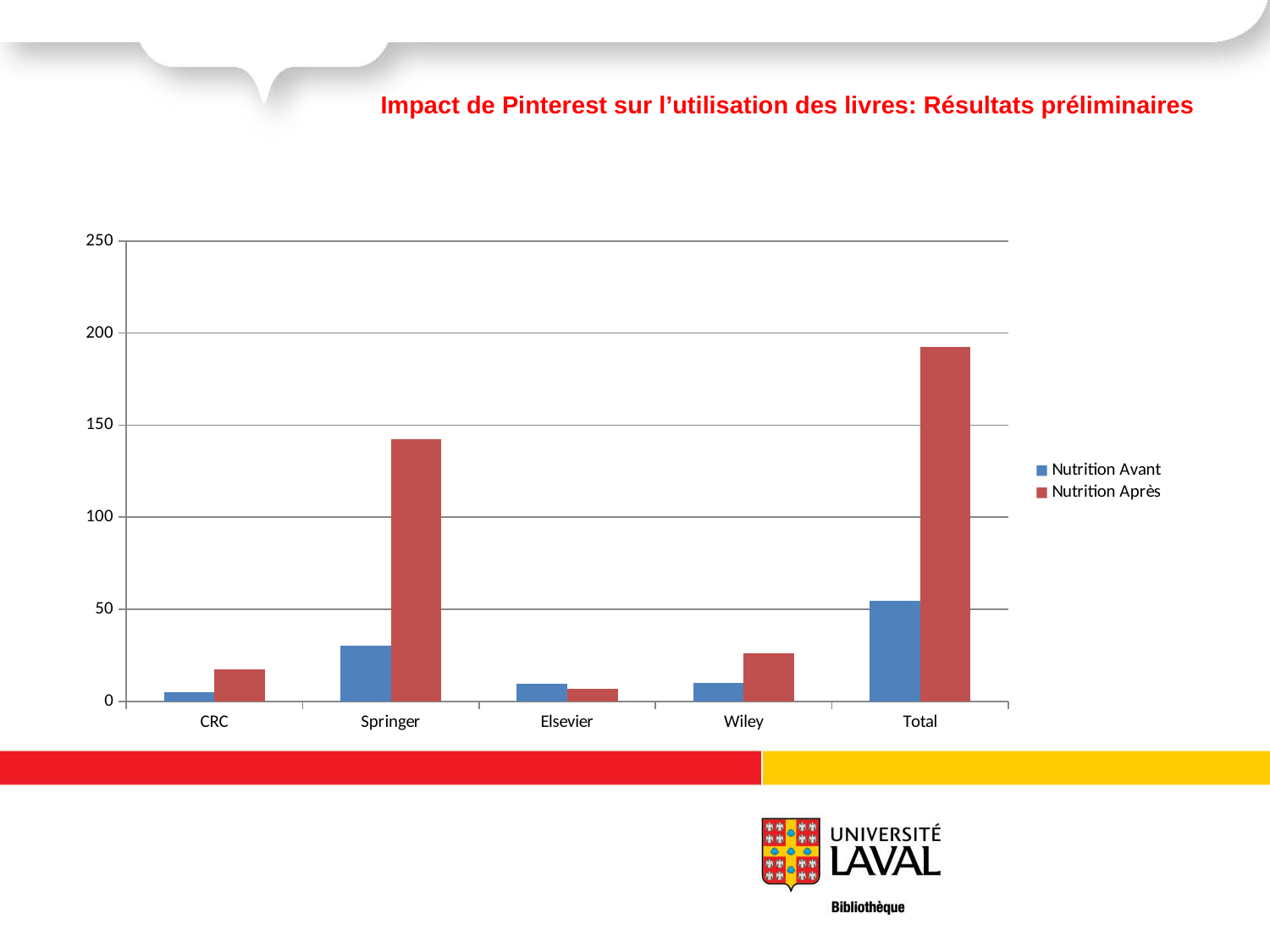
What kind of chart is shown on the slide? bar chart How many series does the chart's legend list? 2 Which category has the highest value for Nutrition Après? Total Which category has the highest value for Nutrition Avant? Total Is the Nutrition Après value for Springer greater or less than 150? less How many categories are shown on the x axis of the chart? 5 What colour represents the Nutrition Après series in the chart? red Is the Nutrition Après value for Total greater or less than 150? greater For Springer, which is larger: Nutrition Avant or Nutrition Après? Nutrition Après Is the Nutrition Avant value for Springer greater or less than 50? less Which is larger: the Nutrition Après value for Wiley or the Nutrition Après value for CRC? Wiley Which category has the lowest value for Nutrition Après? Elsevier